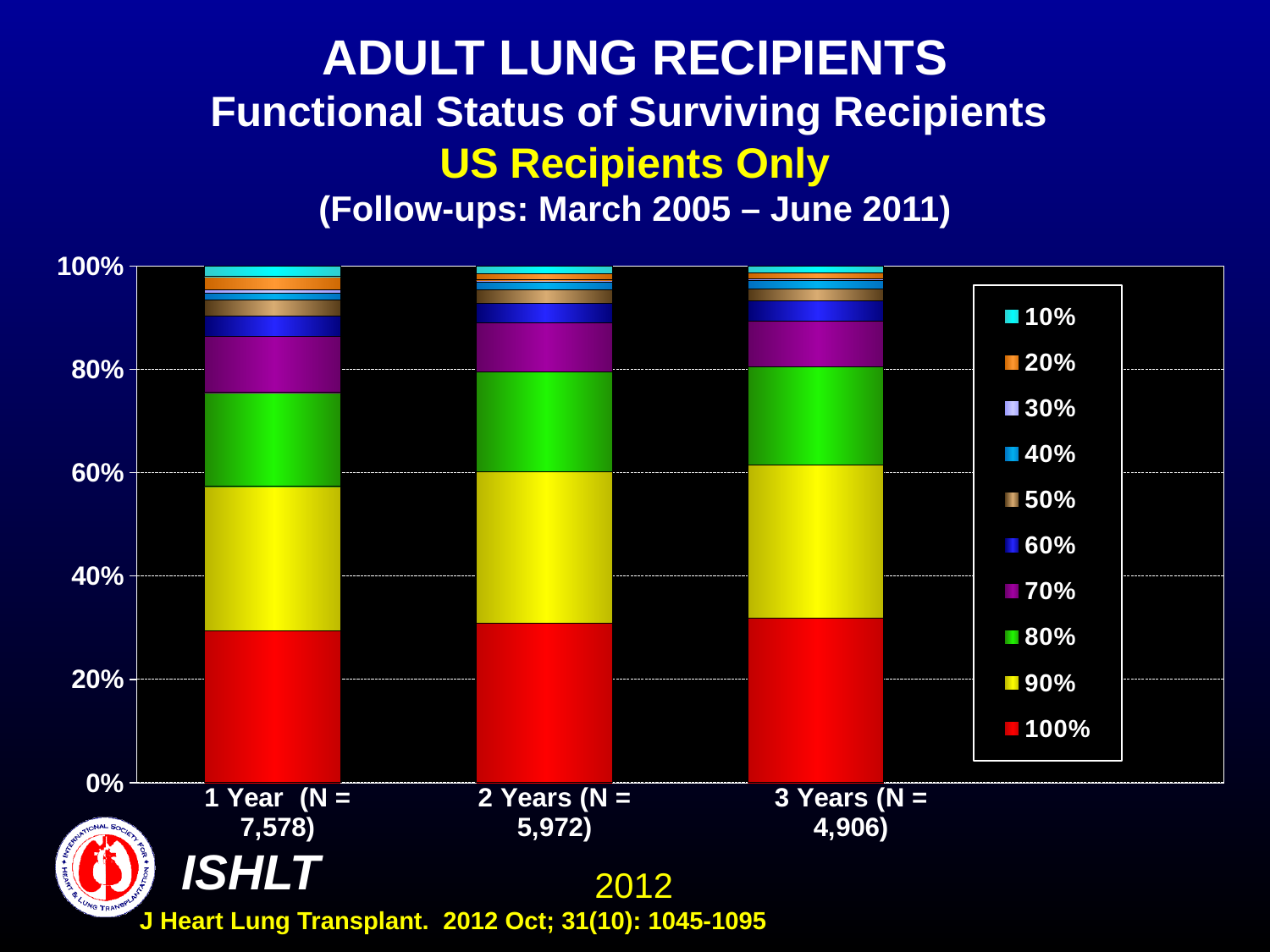
Is the top of the 70% (purple) segment for 1 Year greater or less than 80%? greater Is the 100% functional status segment (red) for 1 Year greater or less than 40%? less Does the 100% functional status segment (red) rise or fall from 1 Year to 3 Years? rise What is the total height of the stacked bar for 2 Years? 100% What kind of chart is shown on the slide? stacked bar chart What is the N shown for the 1 Year category? 7,578 How many categories (time points) are shown on the x axis? 3 What is the N shown for the 3 Years category? 4,906 How many series does the legend list? 10 Is the 100% functional status segment (red) for 3 Years greater or less than 20%? greater